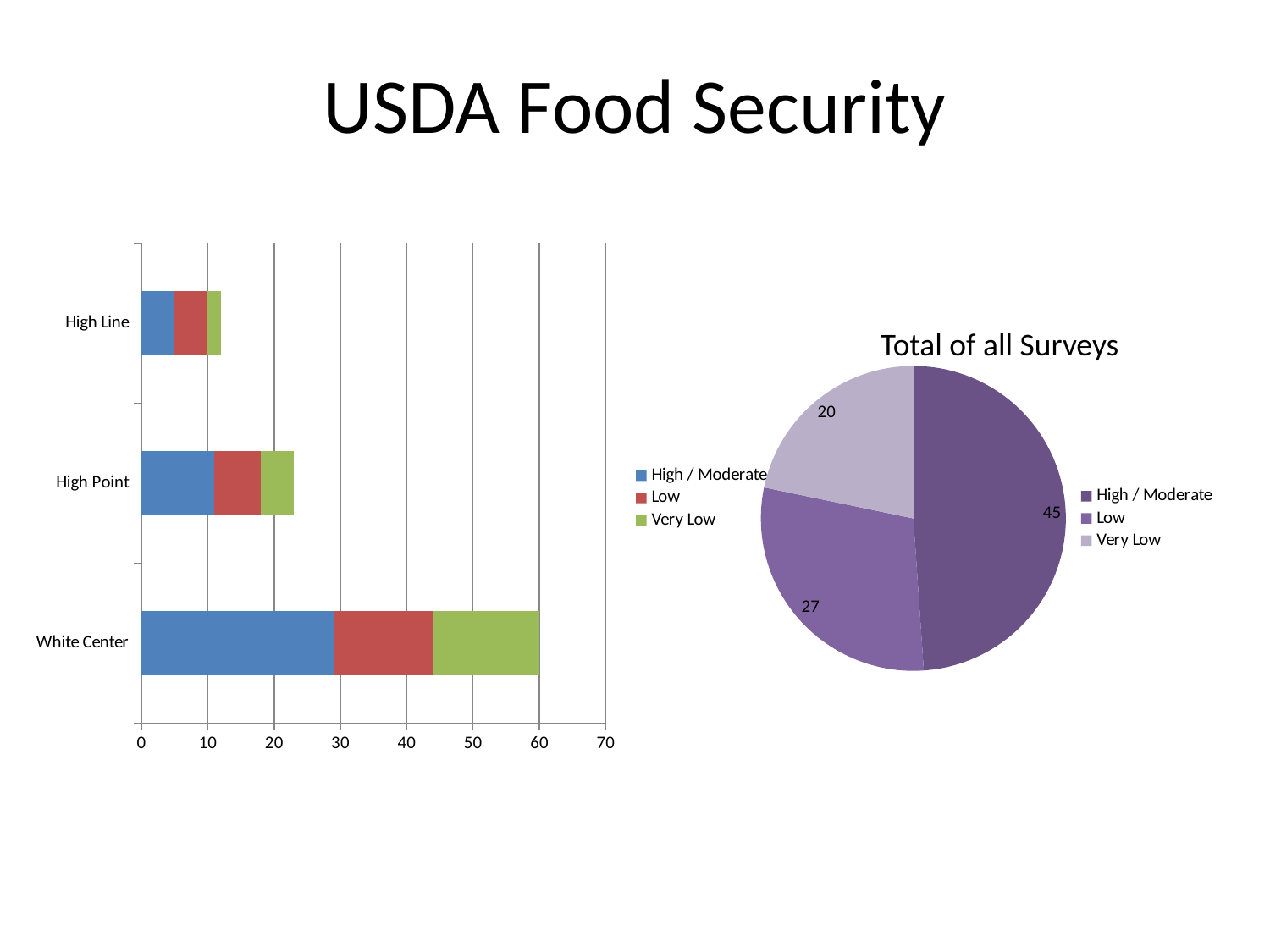
In the 'Total of all Surveys' pie chart, which slice is the largest? High / Moderate In the bar chart on the left, how many categories are shown? 3 What kind of chart is the 'Total of all Surveys' chart? pie chart In the bar chart on the left, which category has the shortest total bar? High Line In the bar chart on the left, how many series does the legend list? 3 In the 'Total of all Surveys' pie chart, what is the difference between the High / Moderate and Very Low values? 25 In the bar chart on the left, which category has the longest total bar? White Center In the bar chart on the left, is the High / Moderate value for White Center greater or less than 20? greater In the 'Total of all Surveys' pie chart, what is the value for Low? 27 In the 'Total of all Surveys' pie chart, which is larger, Low or Very Low? Low What kind of chart is the chart on the left of the slide? bar chart In the bar chart on the left, is the total bar for High Point greater or less than 20? greater